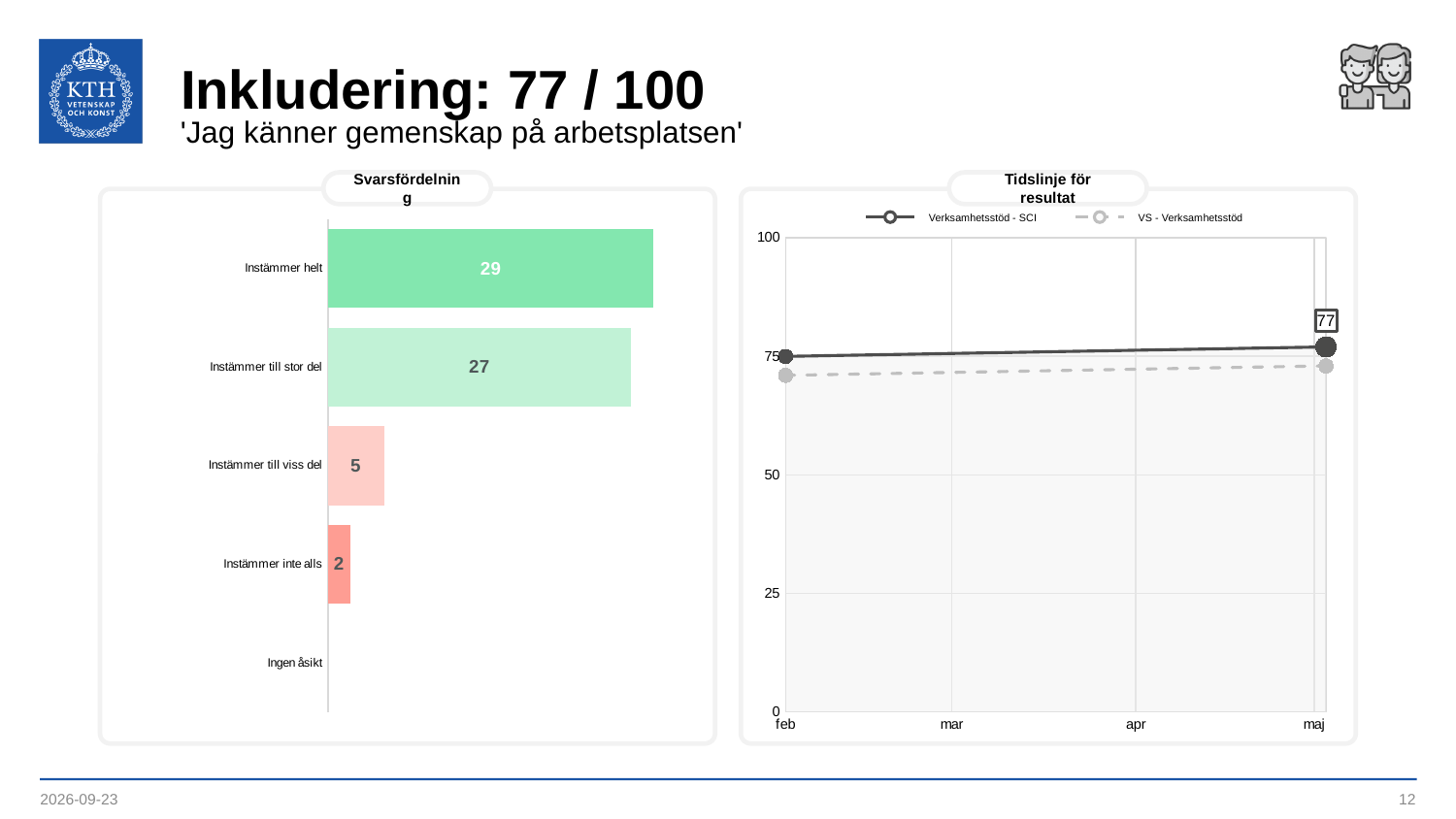
In the 'Svarsfördelning' chart, which category has the highest value? Instämmer helt In the 'Svarsfördelning' chart, which is larger: 'Instämmer till viss del' or 'Instämmer inte alls'? Instämmer till viss del In the 'Svarsfördelning' chart, what is the value for 'Instämmer helt'? 29 In the 'Svarsfördelning' chart, what is the value for 'Instämmer till viss del'? 5 In the 'Svarsfördelning' chart, what is the value for 'Instämmer inte alls'? 2 In the 'Svarsfördelning' chart, what is the value for 'Instämmer till stor del'? 27 What kind of chart is the 'Svarsfördelning' chart? Bar chart In the 'Svarsfördelning' chart, how many categories are listed on the axis? 5 In the 'Tidslinje för resultat' chart, how many series does the legend list? 2 In the 'Svarsfördelning' chart, what is the difference between 'Instämmer helt' and 'Instämmer till stor del'? 2 In the 'Tidslinje för resultat' chart, what is the value for 'Verksamhetsstöd - SCI' in maj? 77 In the 'Tidslinje för resultat' chart, is the value for 'VS - Verksamhetsstöd' in feb greater or less than 75? less